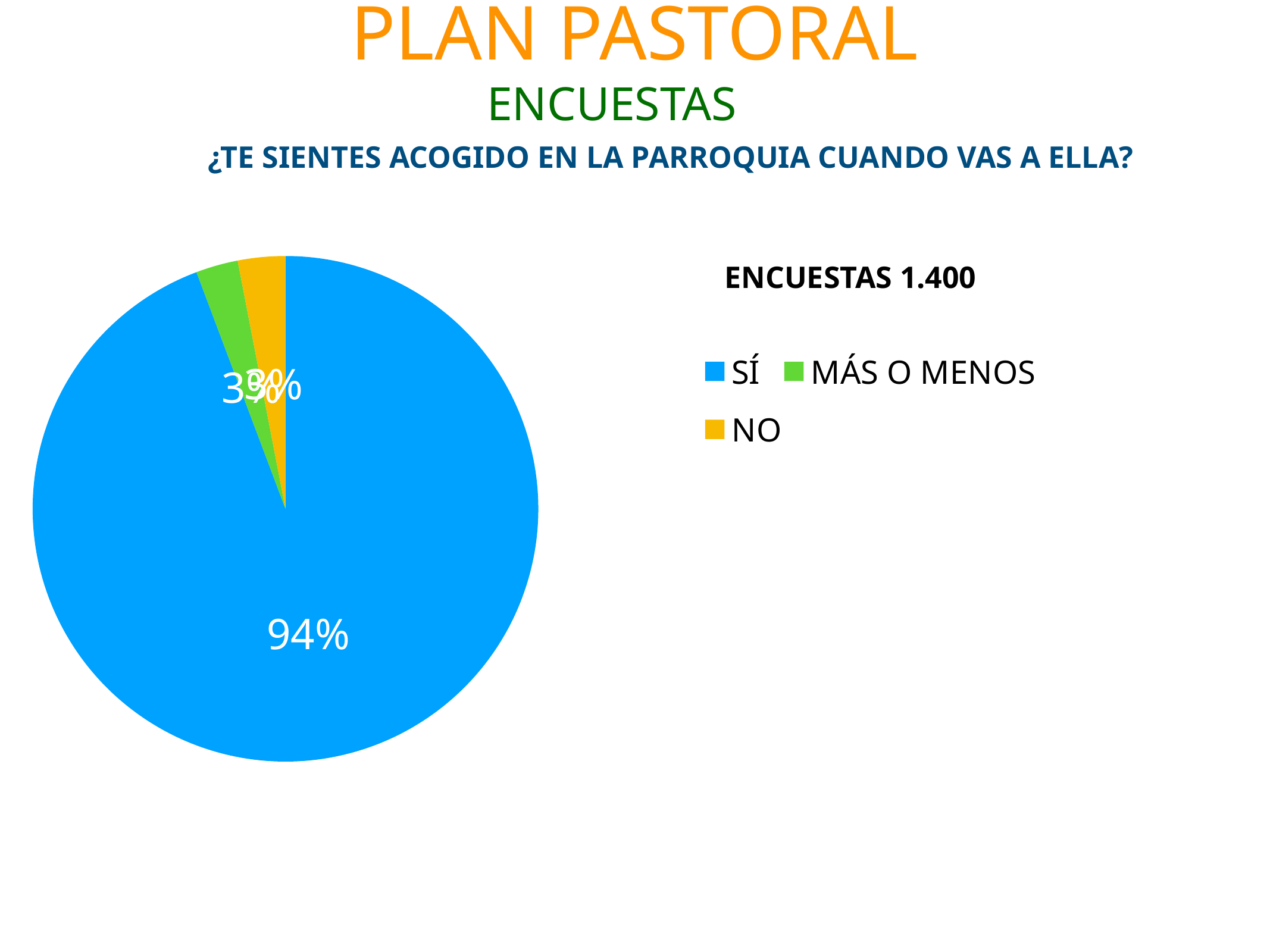
Is the share for SÍ greater or less than 50%? greater Is the share for NO greater or less than 10%? less What question does the chart title ask? ¿TE SIENTES ACOGIDO EN LA PARROQUIA CUANDO VAS A ELLA? What colour is the SÍ slice in the pie chart? blue Which category has the largest share of the pie? SÍ What kind of chart is shown on the slide? pie chart What percentage of respondents answered SÍ? 94% How many entries does the legend list? 3 Which is larger, the share for SÍ or the share for NO? SÍ How many categories does the pie chart show? 3 Which is larger, the share for SÍ or the share for MÁS O MENOS? SÍ